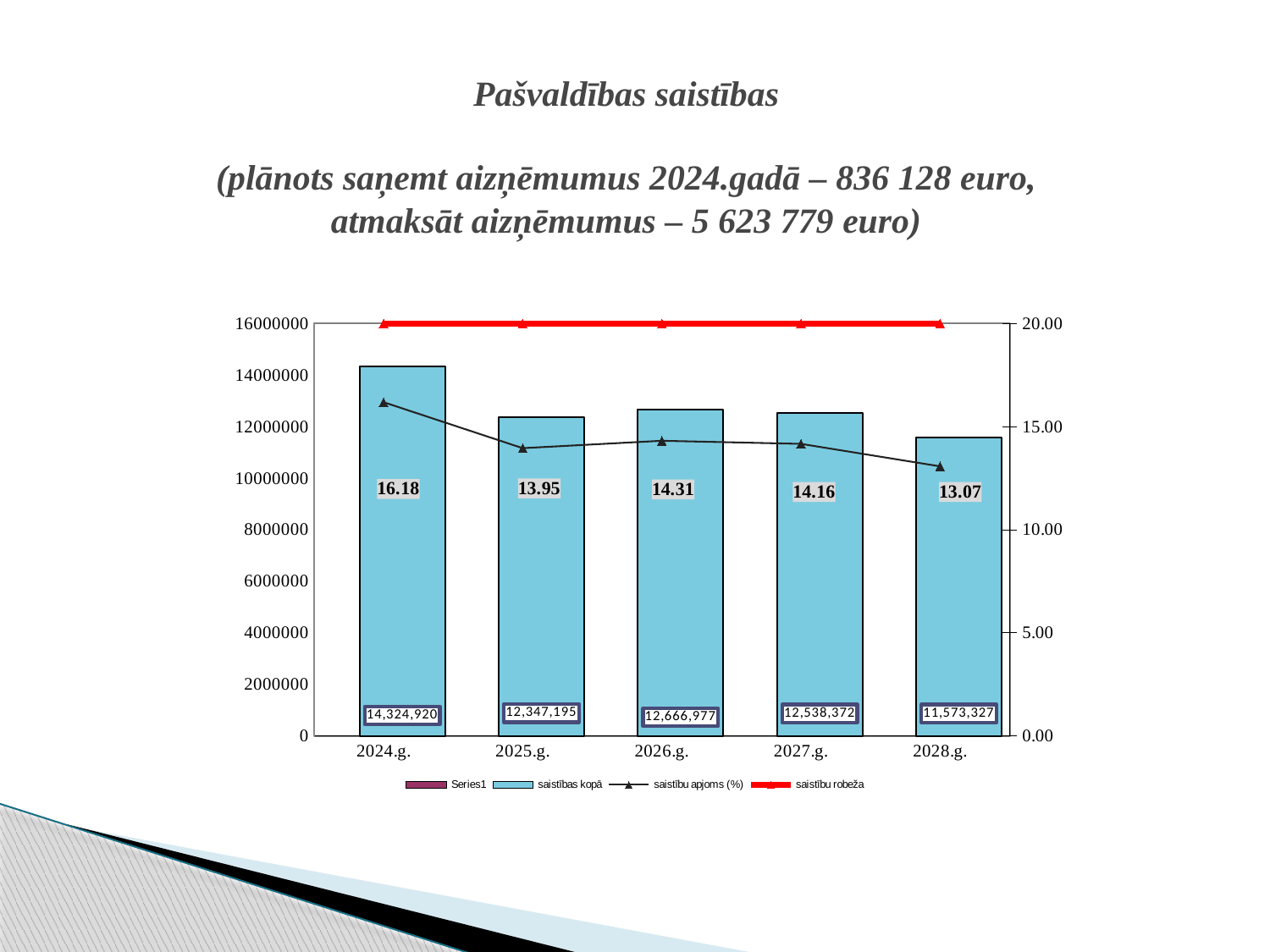
What is the value of 'saistības kopā' for 2024.g.? 14,324,920 What is the 'saistību apjoms (%)' value for 2025.g.? 13.95 Which year has the lowest 'saistību apjoms (%)' value? 2028.g. Is the 'saistības kopā' value for 2028.g. greater or less than 12000000? less What is the 'saistību apjoms (%)' value for 2026.g.? 14.31 Which year has the highest 'saistības kopā' value? 2024.g. What is the value of 'saistības kopā' for 2028.g.? 11,573,327 Which is larger, the 'saistības kopā' value for 2026.g. or for 2027.g.? 2026.g. How many years are shown on the x axis? 5 How many series does the legend list? 4 What is the difference between the 'saistības kopā' values for 2024.g. and 2025.g.? 1,977,725 At what level does the red 'saistību robeža' line sit on the right axis? 20.00